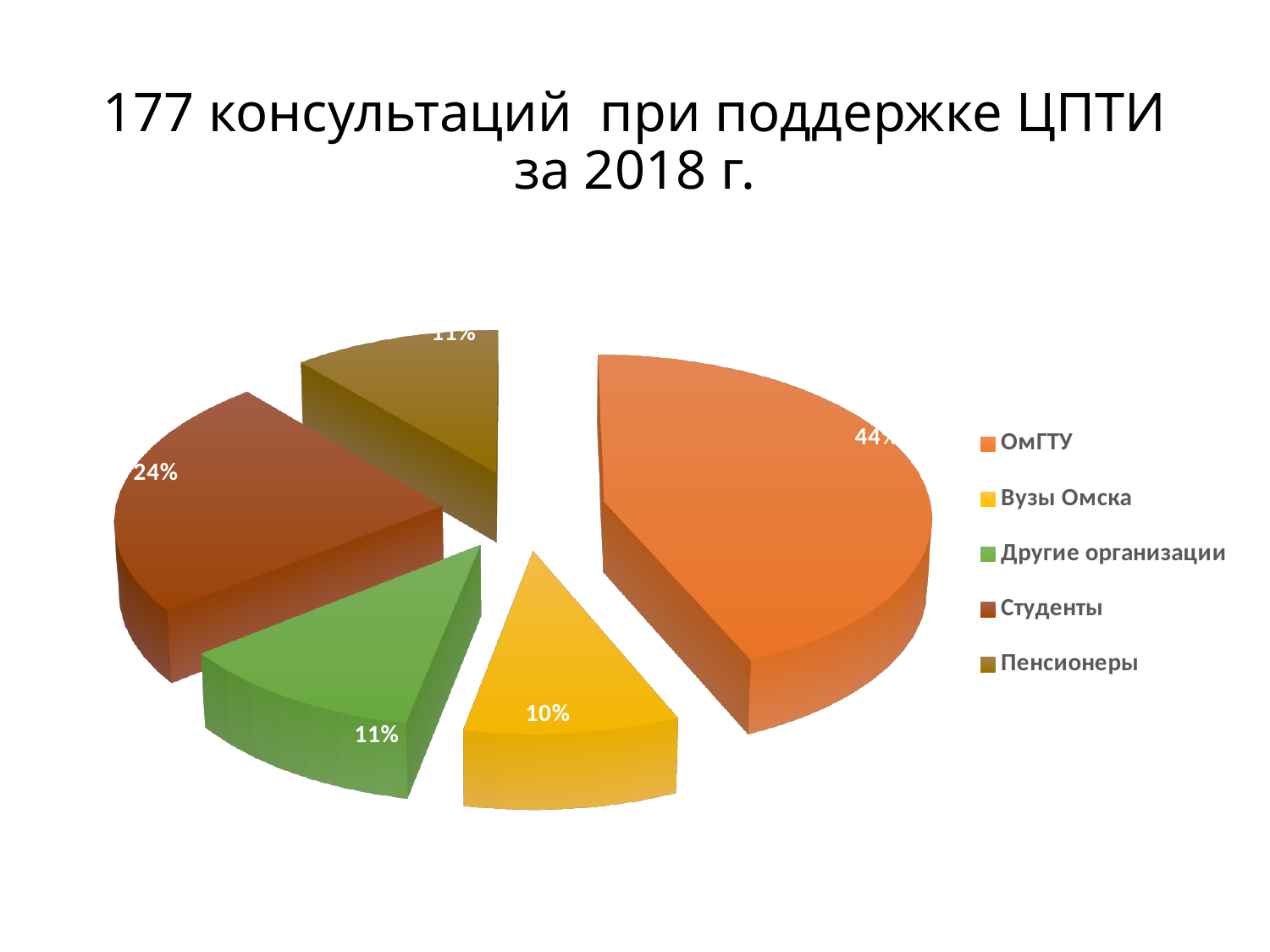
How many entries does the legend list? 5 What is the title of the slide containing the chart? 177 консультаций при поддержке ЦПТИ за 2018 г. What share of the pie does Вузы Омска have? 10% What share of the pie does Студенты have? 24% What is the difference in percentage points between the ОмГТУ share and the Студенты share? 20 Which is larger, the share for Студенты or the share for Другие организации? Студенты How many slices does the pie chart have? 5 What share of the pie does Другие организации have? 11% Which category has the smallest slice of the pie? Вузы Омска What kind of chart is shown on the slide? pie chart Which category has the largest slice of the pie? ОмГТУ